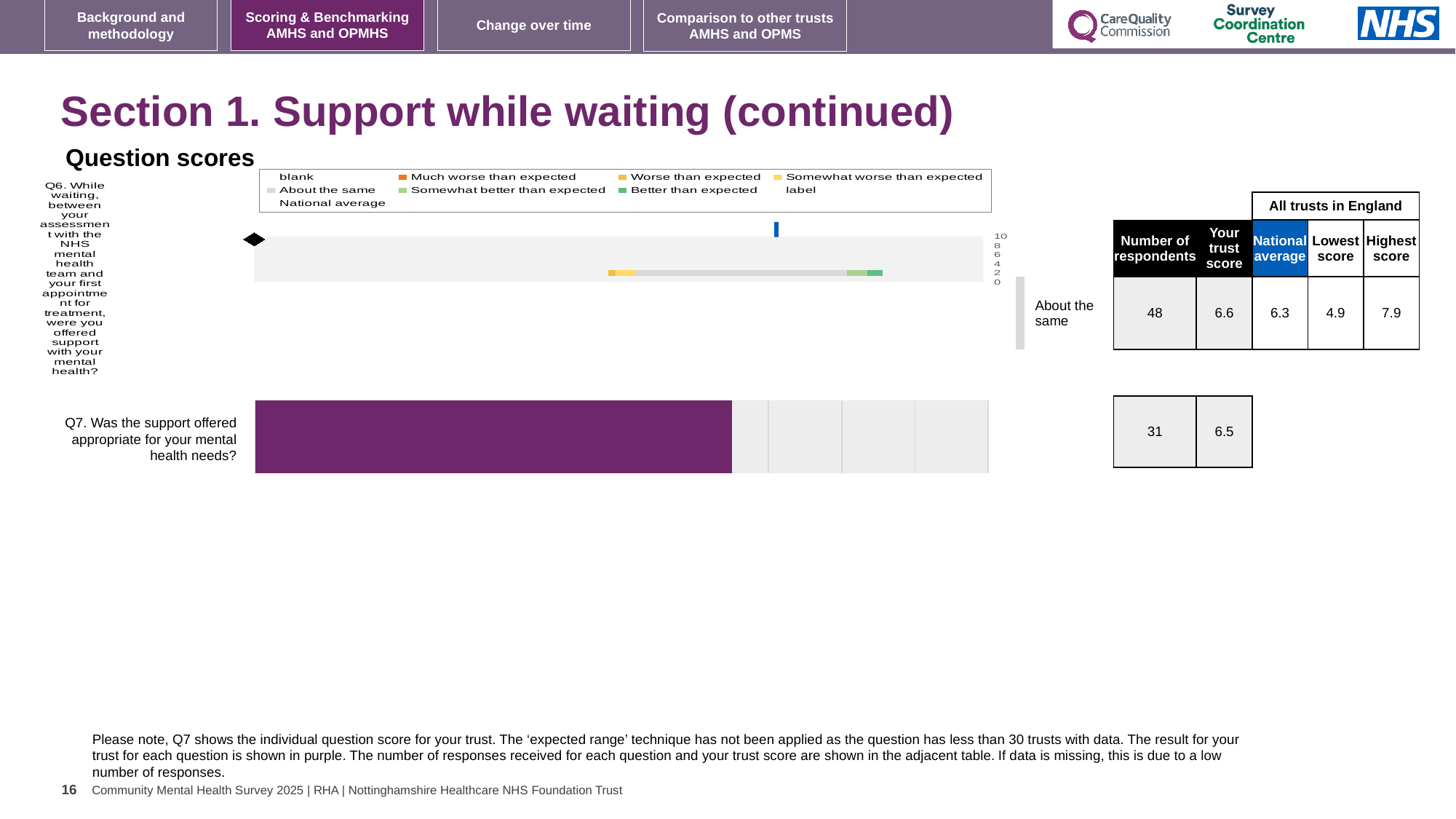
What is the trust score for Q7? 6.5 What is the lowest score among all trusts in England for Q6? 4.9 What is the highest score among all trusts in England for Q6? 7.9 Is the trust score for Q6 greater or less than the national average? greater What category label is shown for Q6's result relative to the expected range? About the same How many respondents answered Q6? 48 What is the difference between the highest and lowest scores for Q6 across all trusts in England? 3.0 Which question has more respondents, Q6 or Q7? Q6 How many respondents answered Q7? 31 What is the trust score for Q6 shown in the table next to the chart? 6.6 What kind of chart is used to show the question scores? bar chart What is the national average score for Q6? 6.3